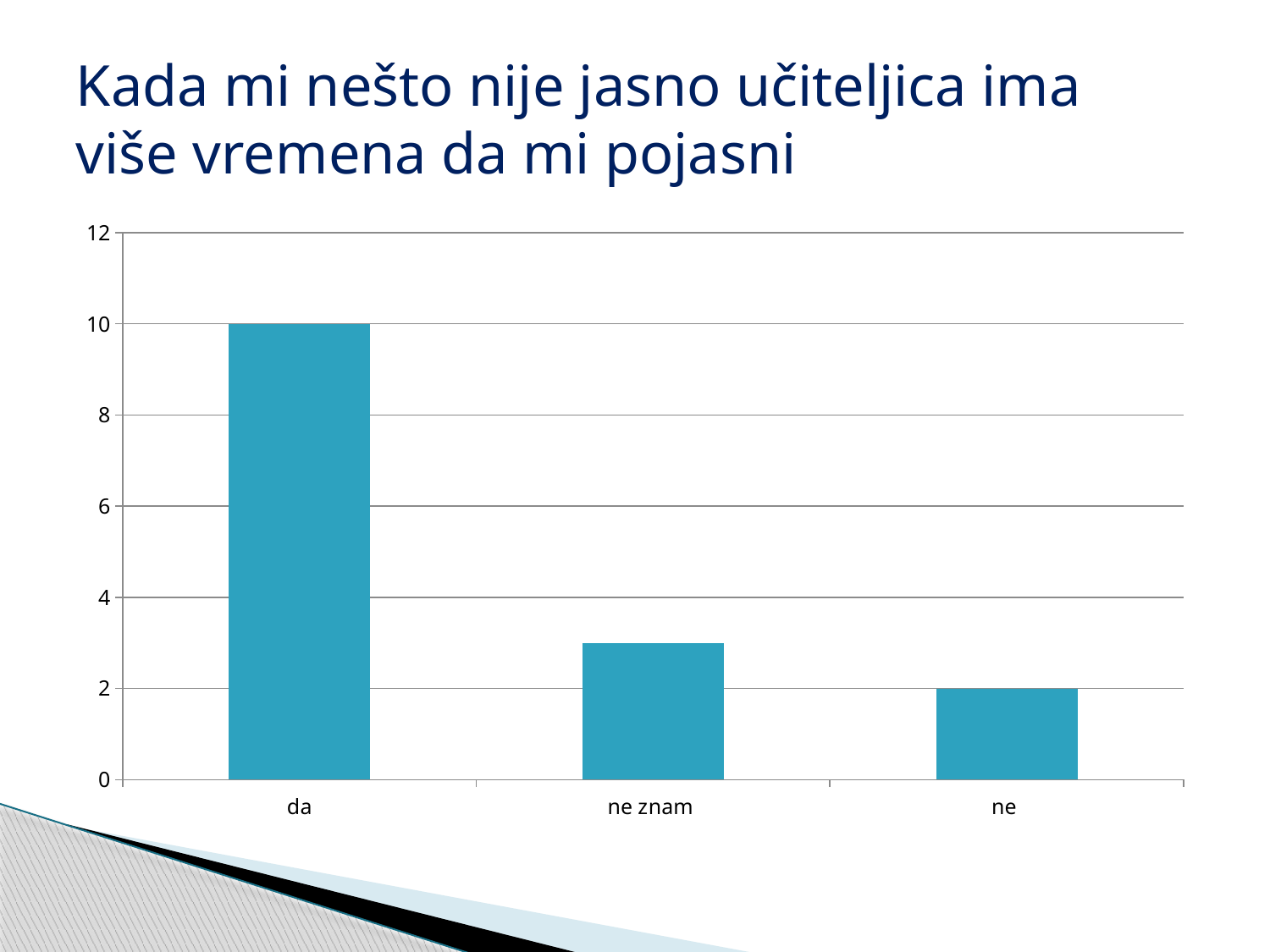
Which category has the highest value? da Which is larger, the value for "ne znam" or the value for "ne"? ne znam What is the maximum value shown on the vertical axis? 12 What is the value for "ne"? 2 Do the values rise or fall from left to right along the x axis? fall Which category has the lowest value? ne How many categories are shown on the x axis? 3 What kind of chart is shown on the slide? bar chart Is the value for "ne znam" greater or less than 2? greater Is the value for "ne znam" greater or less than 4? less What is the difference between the values for "da" and "ne"? 8 What is the value for "da"? 10